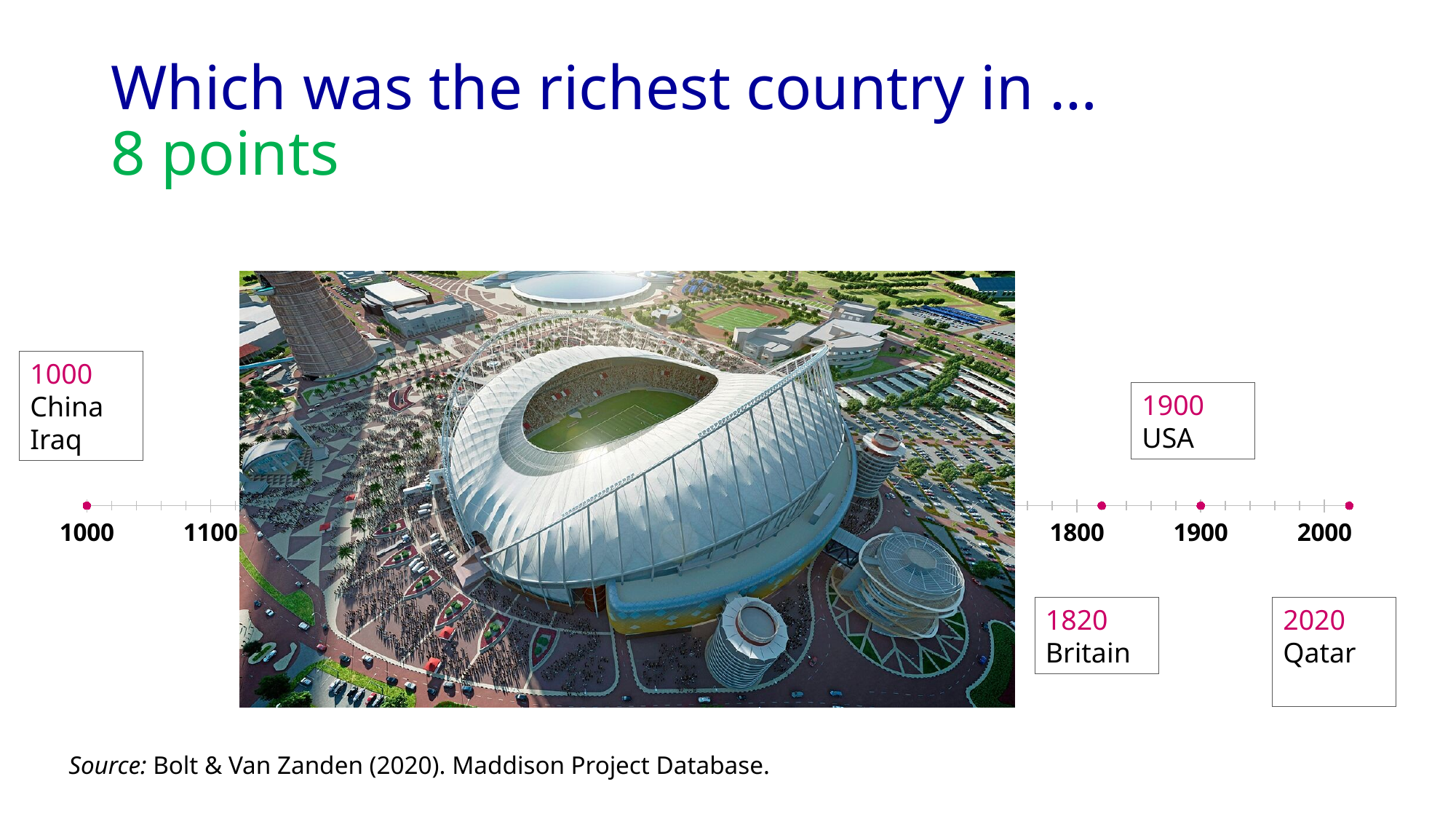
What is the title of the slide containing the timeline? Which was the richest country in ... In which year does the timeline label Britain as the richest country? 1820 How many marked points with labels are shown on the timeline? 4 In which year does the timeline label Qatar as the richest country? 2020 According to the timeline, which country is listed as the richest in 2020? Qatar According to the timeline, which country is listed as the richest in 1900? USA What is the earliest year marked on the timeline? 1000 What source is cited for the timeline data? Bolt & Van Zanden (2020). Maddison Project Database. According to the timeline, which country is listed as the richest in 1820? Britain According to the timeline, which countries are listed as the richest in the year 1000? China and Iraq Which marked year on the timeline comes first, 1820 or 1900? 1820 What is the latest year marked on the timeline? 2020